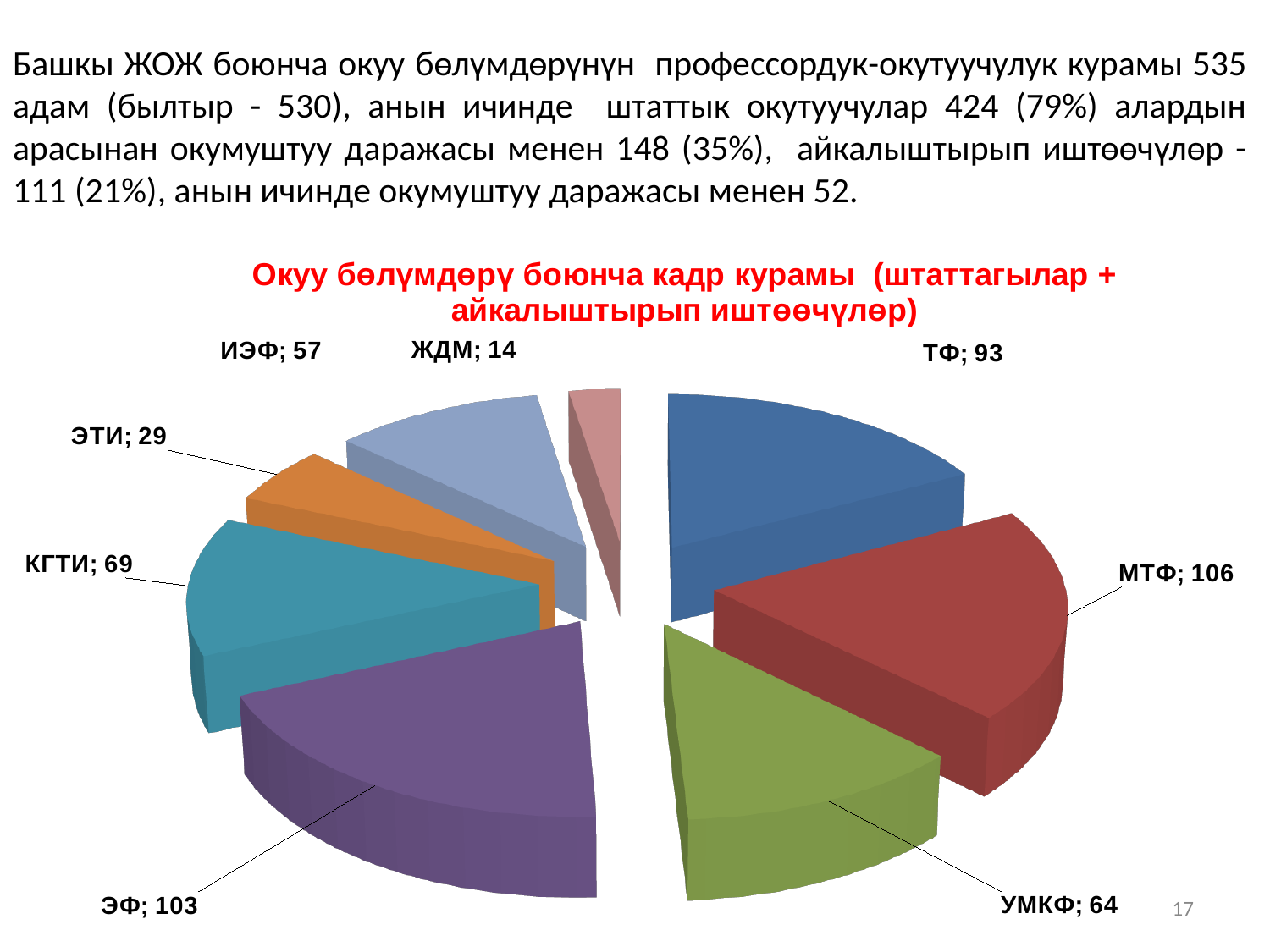
What is the total of all the values shown in the pie chart? 535 What is the difference between the values for МТФ and ЭФ? 3 What kind of chart is shown on the slide? Pie chart How many categories are shown in the pie chart? 8 What is the title of the chart? Окуу бөлүмдөрү боюнча кадр курамы (штаттагылар + айкалыштырып иштөөчүлөр) What is the value for ТФ in the pie chart? 93 Which category has the smallest slice in the pie chart? ЖДМ What is the value for ИЭФ in the pie chart? 57 What is the value for ЭТИ in the pie chart? 29 Which category has the largest slice in the pie chart? МТФ What is the difference between the values for ТФ and УМКФ? 29 Which is larger, the value for КГТИ or the value for УМКФ? КГТИ